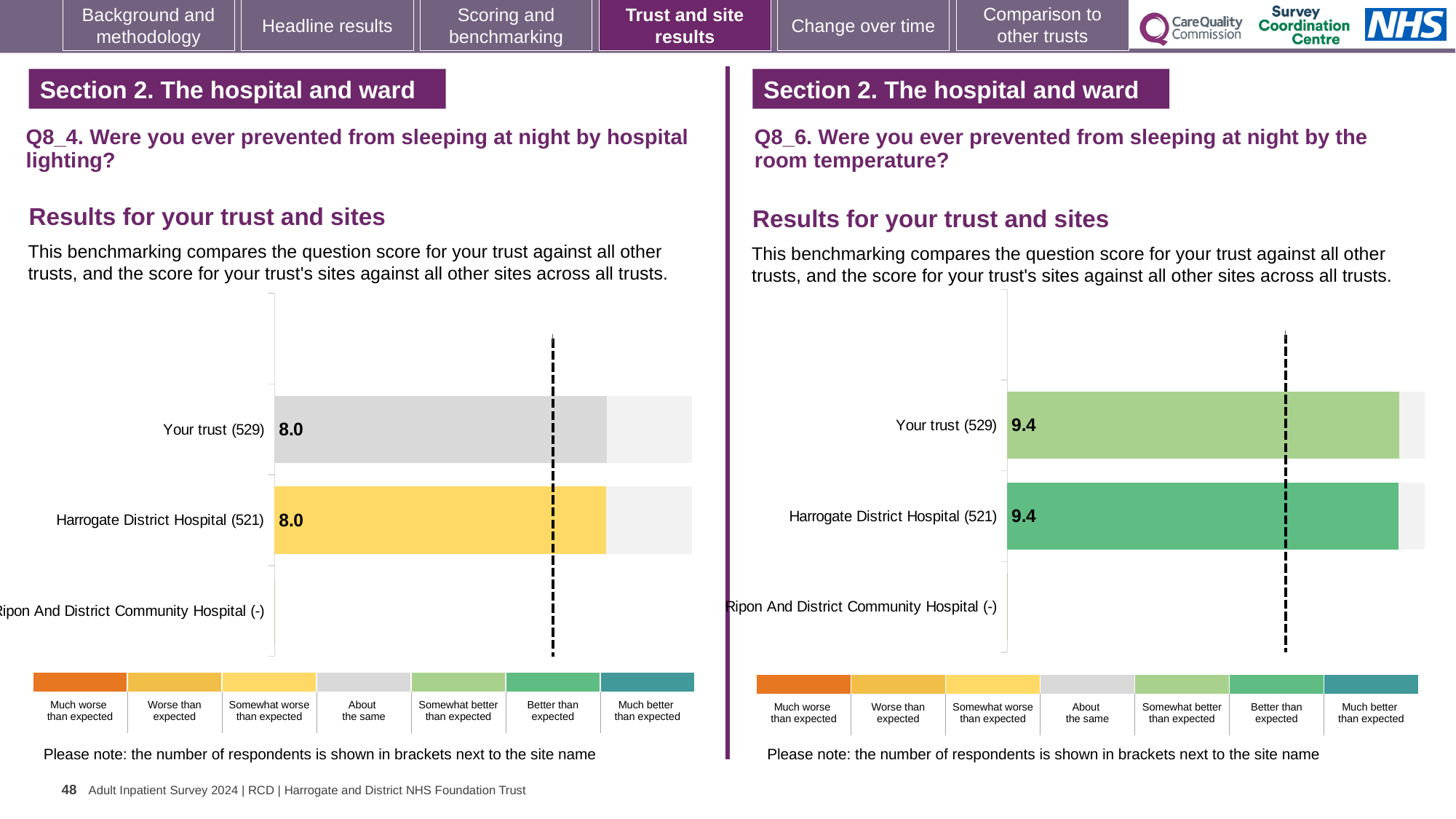
On the right chart (Q8_6, room temperature), what is the score for Harrogate District Hospital (521)? 9.4 On the right chart (Q8_6), which benchmark category does the colour of the Harrogate District Hospital bar correspond to? Better than expected What kind of chart is used on the left (Q8_4) side of the slide? Bar chart How many site/trust categories are listed on the right chart (Q8_6)? 3 How many site/trust categories are listed on the left chart (Q8_4)? 3 On the left chart (Q8_4), how many respondents are shown in brackets for Your trust? 529 On the left chart (Q8_4, hospital lighting), what is the score for Your trust (529)? 8.0 On the right chart (Q8_6), what is the difference between the scores for Your trust (529) and Harrogate District Hospital (521)? 0.0 On the right chart (Q8_6, room temperature), what is the score for Your trust (529)? 9.4 On the left chart (Q8_4), which benchmark category does the colour of the Harrogate District Hospital bar correspond to? Somewhat worse than expected On the left chart (Q8_4, hospital lighting), what is the score for Harrogate District Hospital (521)? 8.0